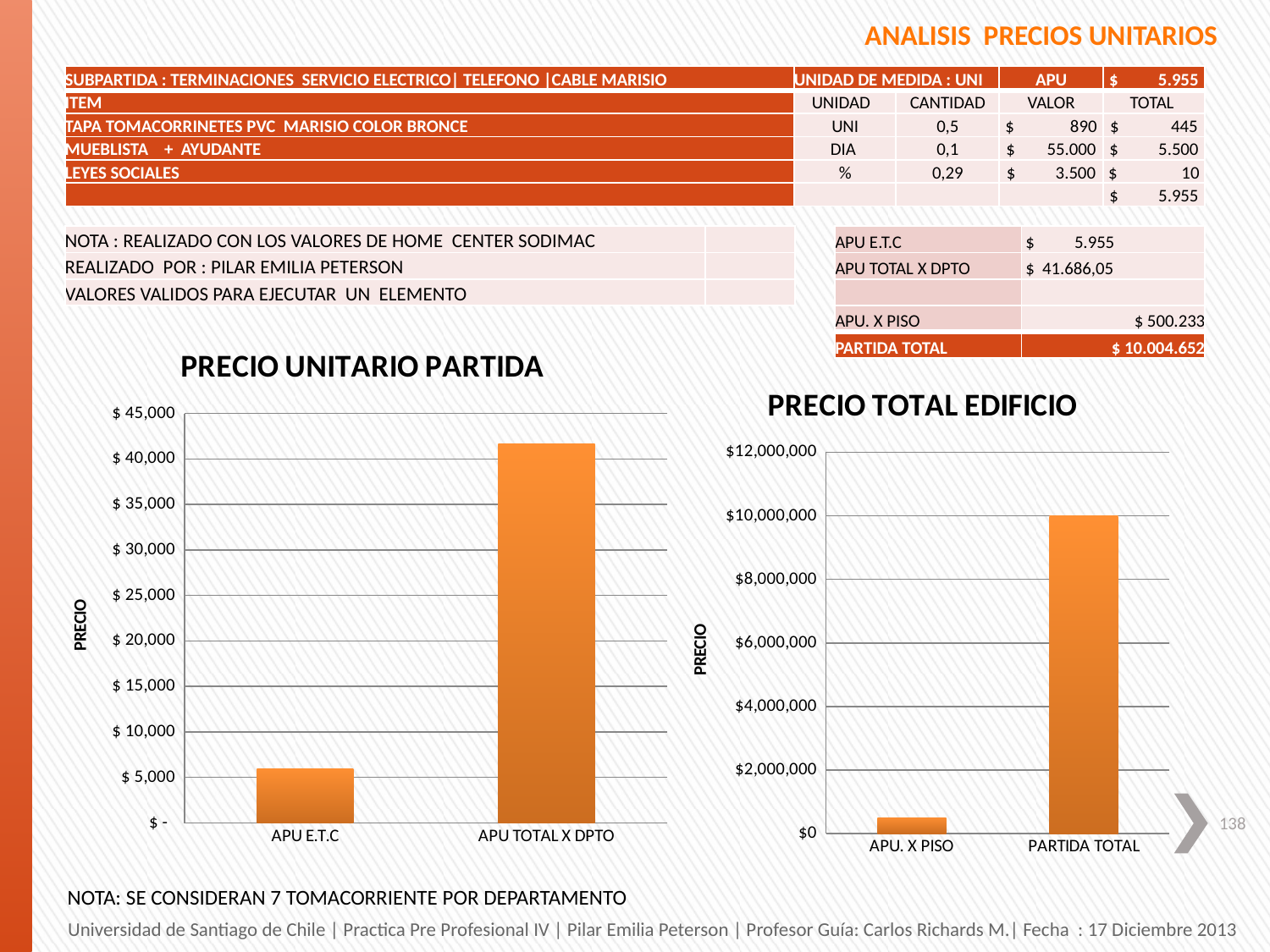
In the PRECIO TOTAL EDIFICIO chart, which category has the lowest value? APU. X PISO In the PRECIO TOTAL EDIFICIO chart, which category has the highest value? PARTIDA TOTAL In the PRECIO UNITARIO PARTIDA chart, is the value for APU E.T.C greater or less than $ 10,000? less In the PRECIO TOTAL EDIFICIO chart, is the value for APU. X PISO greater or less than $2,000,000? less What kind of chart is the PRECIO TOTAL EDIFICIO chart? bar chart In the PRECIO UNITARIO PARTIDA chart, which category has the lowest value? APU E.T.C What kind of chart is the PRECIO UNITARIO PARTIDA chart? bar chart What is the label of the vertical axis in the PRECIO TOTAL EDIFICIO chart? PRECIO In the PRECIO UNITARIO PARTIDA chart, which category has the highest value? APU TOTAL X DPTO In the PRECIO UNITARIO PARTIDA chart, is the value for APU TOTAL X DPTO greater or less than $ 35,000? greater How many categories are shown in the PRECIO UNITARIO PARTIDA chart? 2